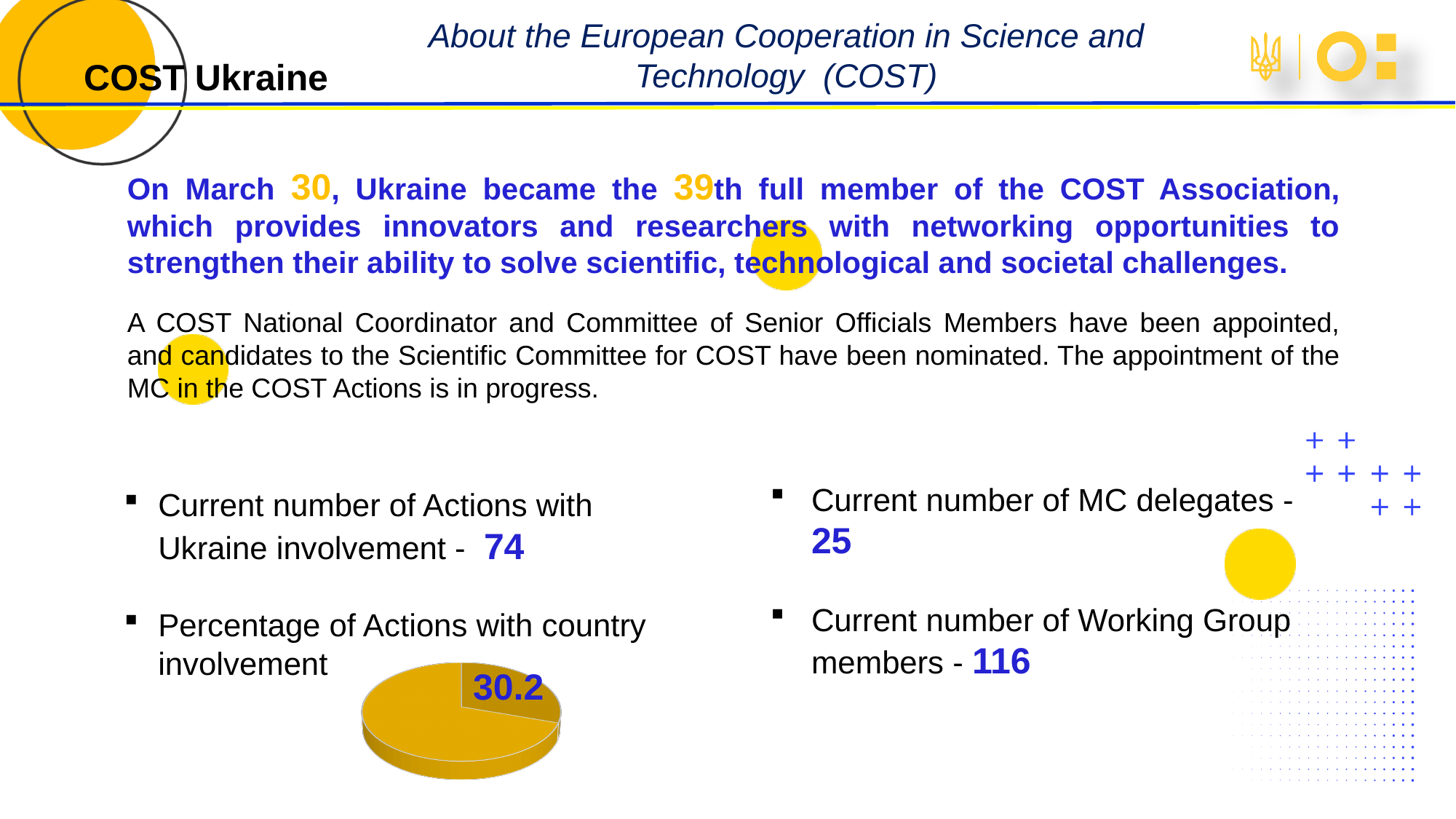
What colour is the pie chart drawn in? gold/yellow How many slices does the pie chart have? 2 Which bullet point does the pie chart illustrate? Percentage of Actions with country involvement What value is printed on the labelled slice of the pie chart? 30.2 What share of the pie does the labelled slice represent? 30.2 Is the slice labelled 30.2 the larger or the smaller slice of the pie chart? smaller What kind of chart is shown at the bottom left of the slide? pie chart